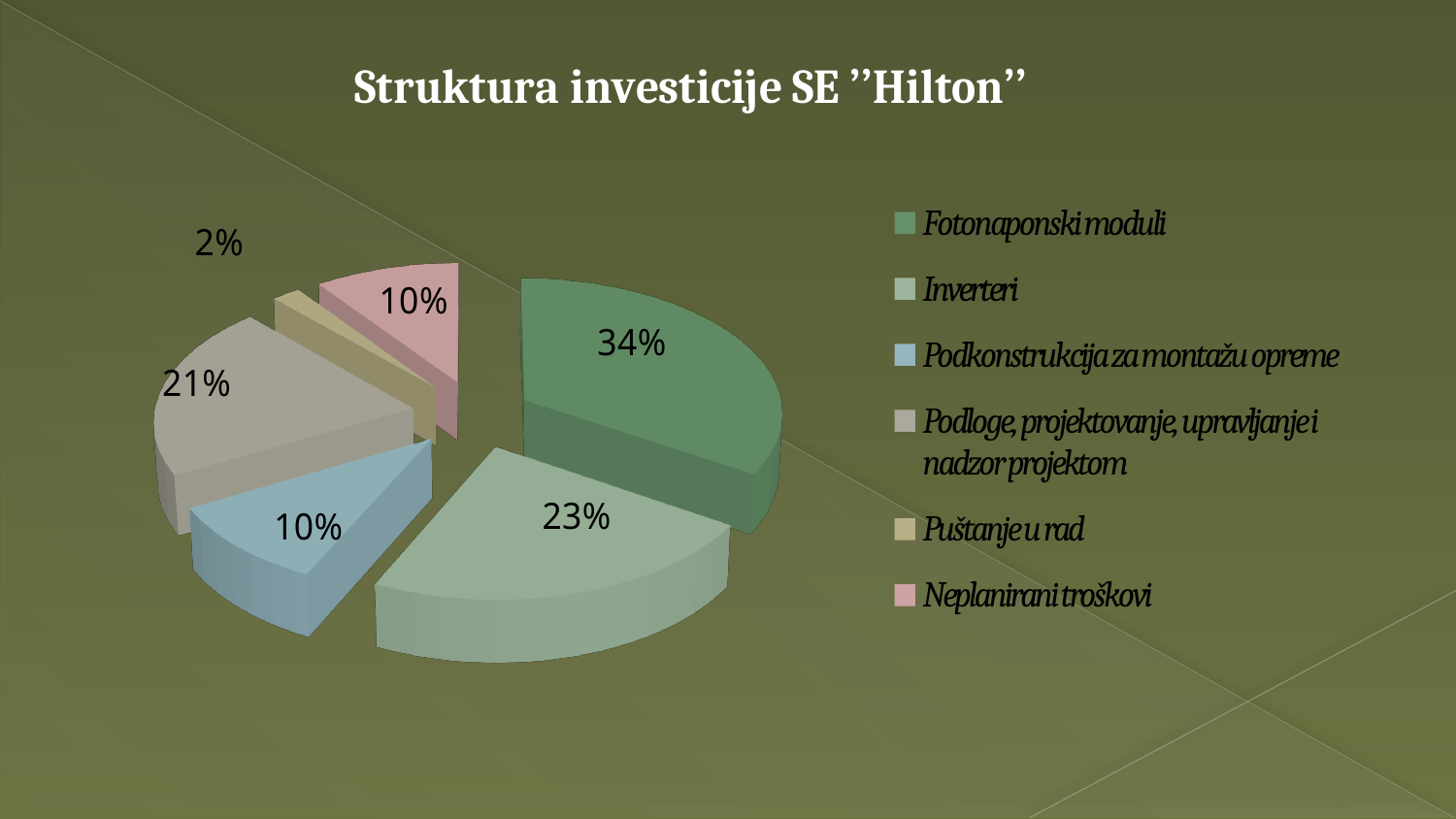
How many entries does the legend list? 6 How many slices does the pie chart have? 6 What share of the investment is Puštanje u rad? 2% What is the title of the chart? Struktura investicije SE ''Hilton'' What kind of chart is shown on the slide? Pie chart What share of the investment is Podloge, projektovanje, upravljanje i nadzor projektom? 21% Which is larger, the share for Inverteri or the share for Podloge, projektovanje, upravljanje i nadzor projektom? Inverteri Which category has the smallest share of the pie? Puštanje u rad What share of the investment is Inverteri? 23% Which category has the largest share of the pie? Fotonaponski moduli What is the difference in percentage points between Fotonaponski moduli and Inverteri? 11 percentage points